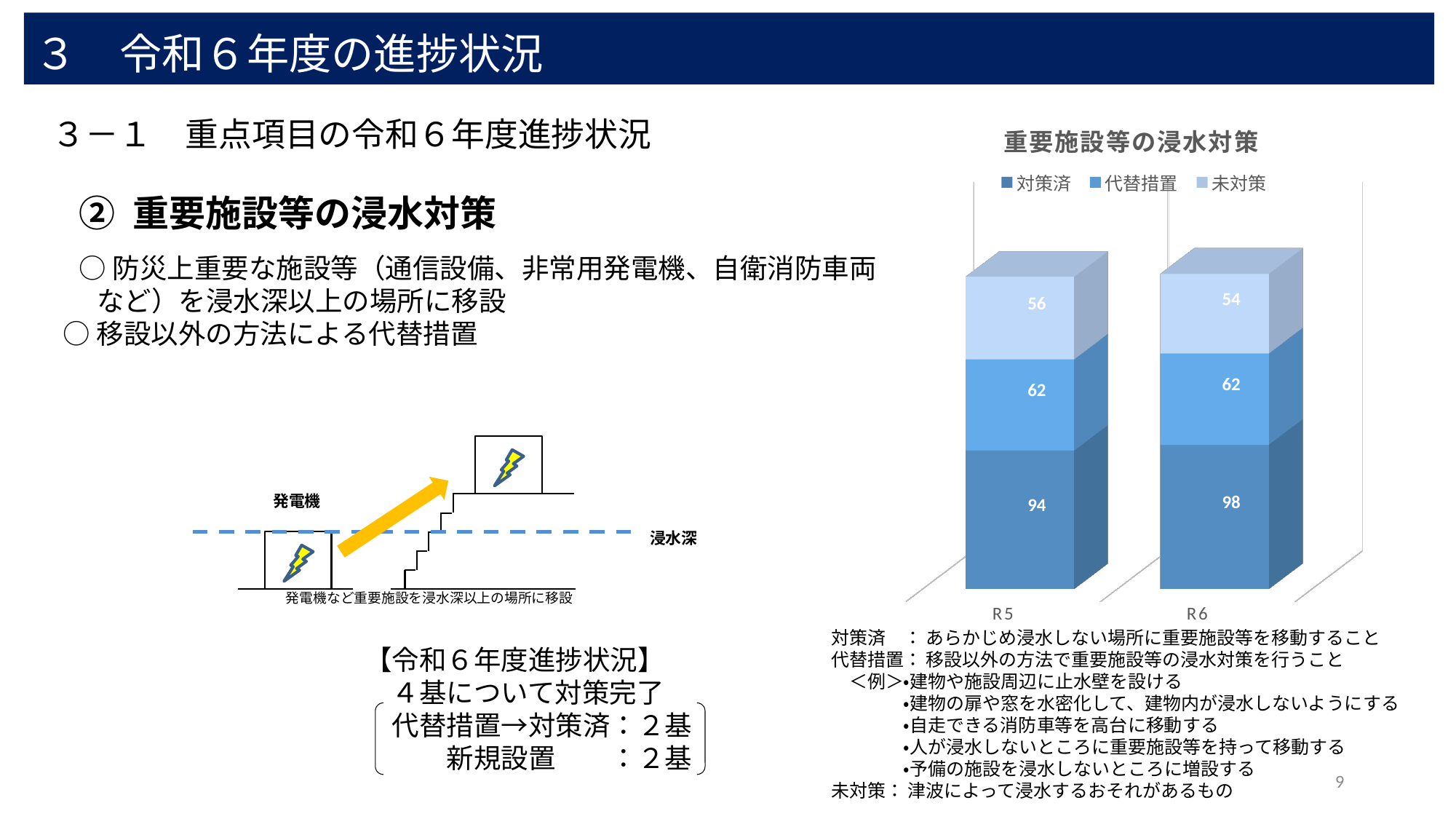
What kind of chart is 重要施設等の浸水対策? Stacked bar chart What is the total of the stacked bar for R5 in the chart 重要施設等の浸水対策? 212 In the chart 重要施設等の浸水対策, what is the difference between the 対策済 values for R6 and R5? 4 In the chart 重要施設等の浸水対策, what is the difference between the 未対策 values for R5 and R6? 2 What is the total of the stacked bar for R6 in the chart 重要施設等の浸水対策? 214 Which series in the chart 重要施設等の浸水対策 has the smallest value for R6? 未対策 What is the value of 対策済 for R5 in the chart 重要施設等の浸水対策? 94 How many categories are shown on the x axis of the chart 重要施設等の浸水対策? 2 In the chart 重要施設等の浸水対策, which category has the higher 対策済 value, R5 or R6? R6 How many series does the legend of the chart 重要施設等の浸水対策 list? 3 What is the value of 未対策 for R6 in the chart 重要施設等の浸水対策? 54 What is the value of 代替措置 for R6 in the chart 重要施設等の浸水対策? 62